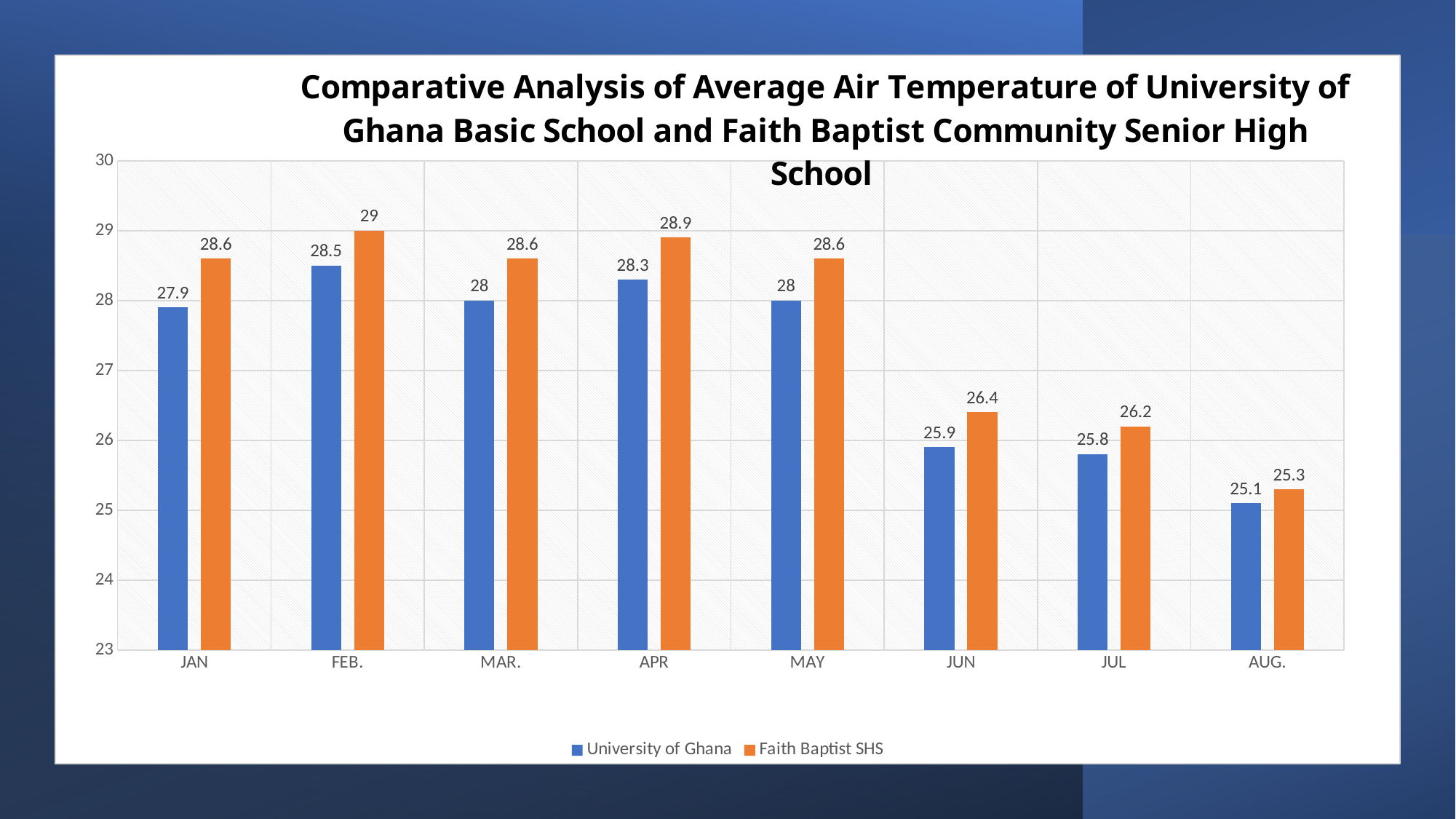
In which month is the University of Ghana value lowest? AUG. What kind of chart is shown on the slide? Bar chart What is the University of Ghana value for JAN? 27.9 Which colour represents Faith Baptist SHS in the chart? Orange What is the difference between the Faith Baptist SHS and University of Ghana values in FEB.? 0.5 How many series does the legend list? 2 What is the University of Ghana value for AUG.? 25.1 How many months are shown on the x axis? 8 What is the Faith Baptist SHS value for APR? 28.9 Which is larger in JUN: the University of Ghana value or the Faith Baptist SHS value? Faith Baptist SHS Do the University of Ghana values rise or fall from MAY to AUG.? Fall In which month is the Faith Baptist SHS value highest? FEB.